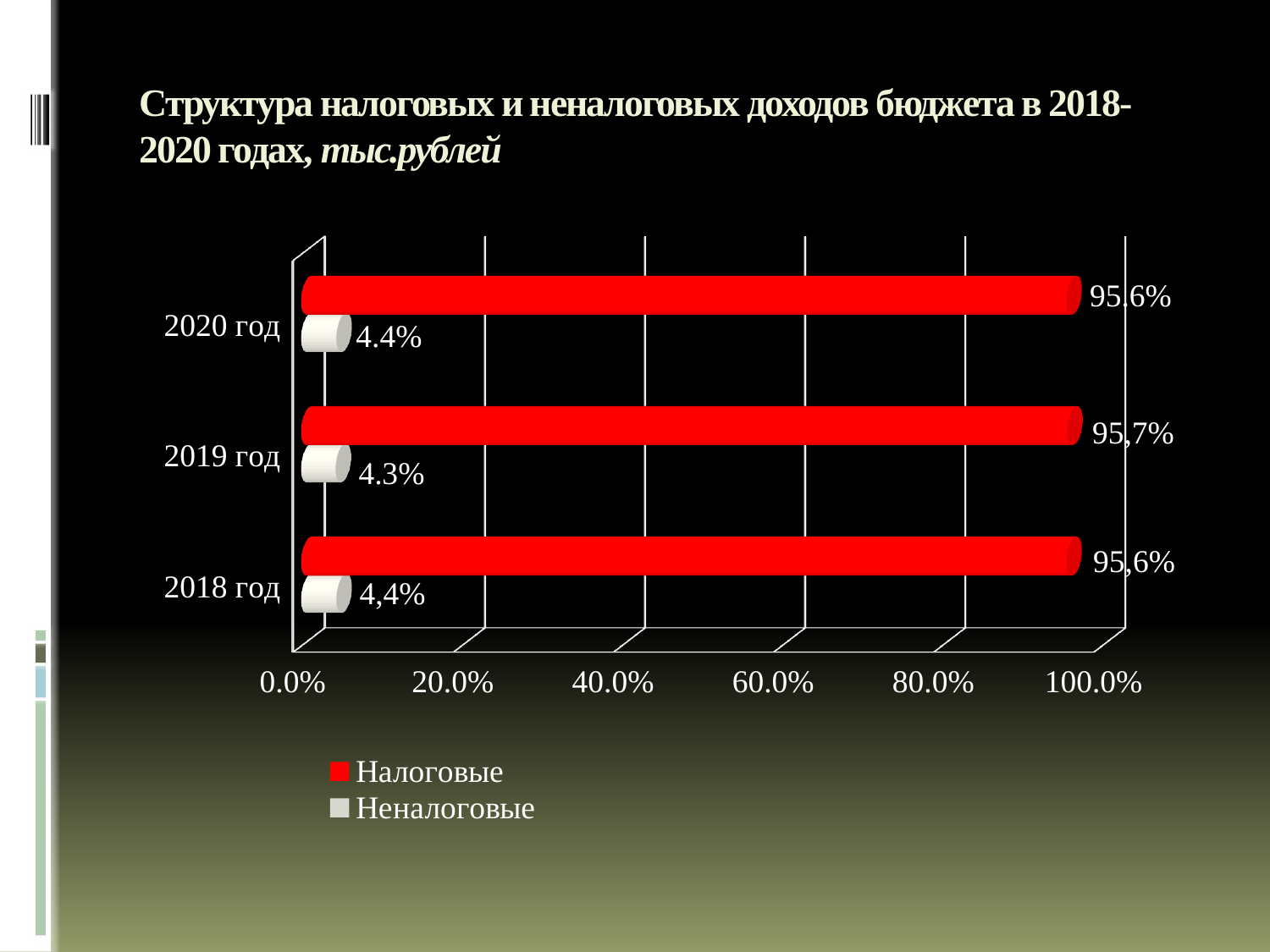
What is the difference between Налоговые and Неналоговые for 2018 год? 91,2% In which year is the Неналоговые value lowest? 2019 год What is the value of Налоговые for 2020 год? 95.6% How many year categories are shown on the chart? 3 What is the value of Неналоговые for 2018 год? 4,4% What type of chart is shown on the slide? bar chart Which colour represents the Налоговые series? red In which year is the Налоговые value highest? 2019 год Which is larger for 2020 год: Налоговые or Неналоговые? Налоговые What is the value of Налоговые for 2018 год? 95,6% What is the value of Неналоговые for 2019 год? 4.3% How many series does the legend list? 2